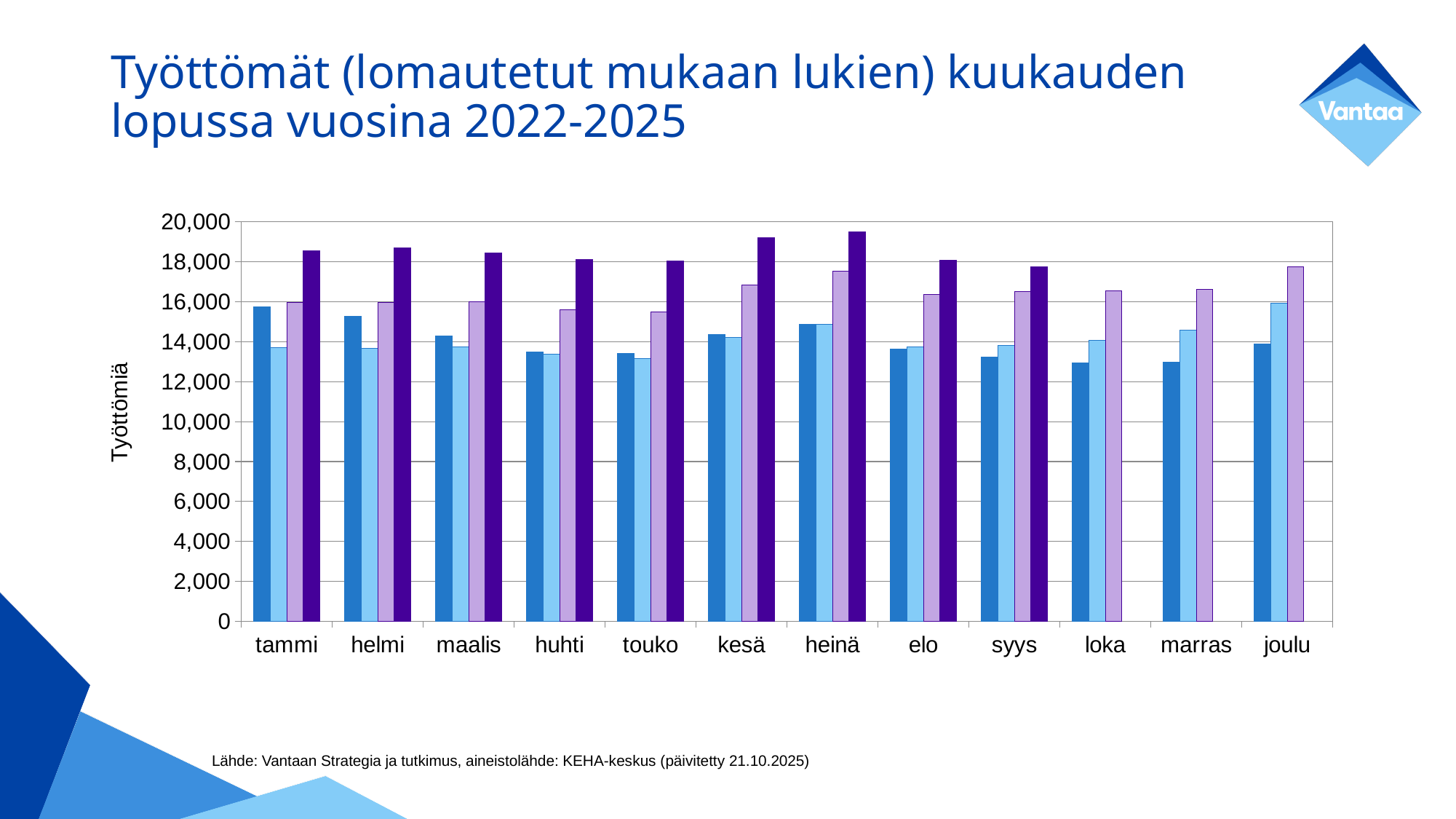
Is the dark purple bar for syys greater or less than 16,000? greater Is the dark purple bar for heinä greater or less than 18,000? greater What is the title of the chart's vertical axis? Työttömiä Do the dark blue bars rise or fall from tammi to maalis? fall Among the dark purple bars, which month has the highest value? heinä How many months in the chart have only three bars instead of four? 3 Is the light purple bar for joulu greater or less than 16,000? greater Which is larger: the light purple bar for kesä or the light purple bar for huhti? kesä How many months are shown on the x axis of the chart? 12 What kind of chart is shown on the slide? bar chart In heinä, which is larger: the dark purple bar or the dark blue bar? the dark purple bar